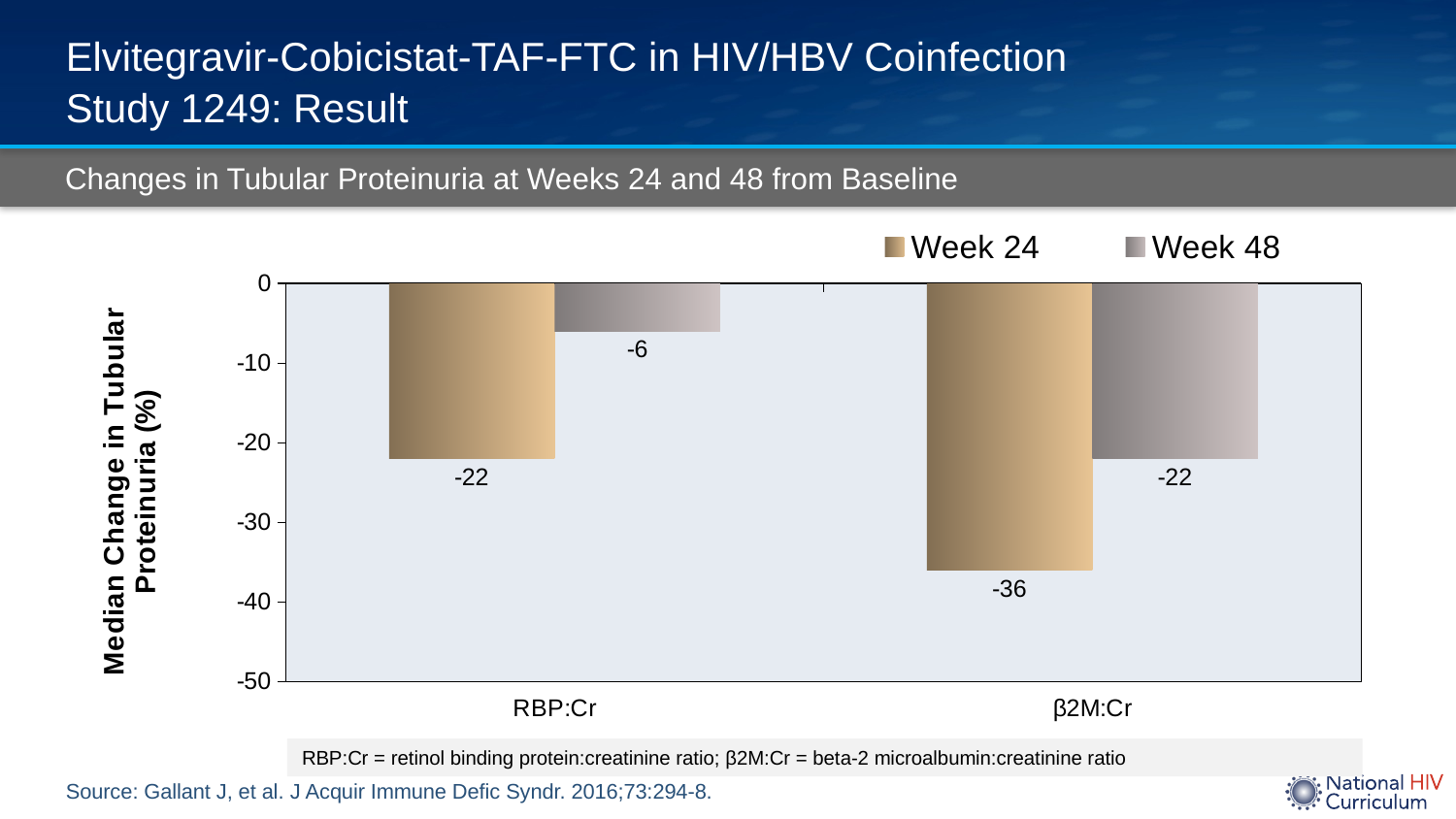
What is the difference between the Week 24 and Week 48 values for RBP:Cr? 16 Is the Week 24 value for β2M:Cr greater or less than -30? less What is the difference between the Week 24 and Week 48 values for β2M:Cr? 14 How many series does the legend list? 2 Which category has the highest Week 48 value? RBP:Cr What is the Week 24 value for RBP:Cr? -22 Which category has the lowest Week 24 value? β2M:Cr What is the Week 24 value for β2M:Cr? -36 How many categories are shown on the x axis? 2 What is the Week 48 value for β2M:Cr? -22 What is the Week 48 value for RBP:Cr? -6 What kind of chart is shown on the slide? Bar chart